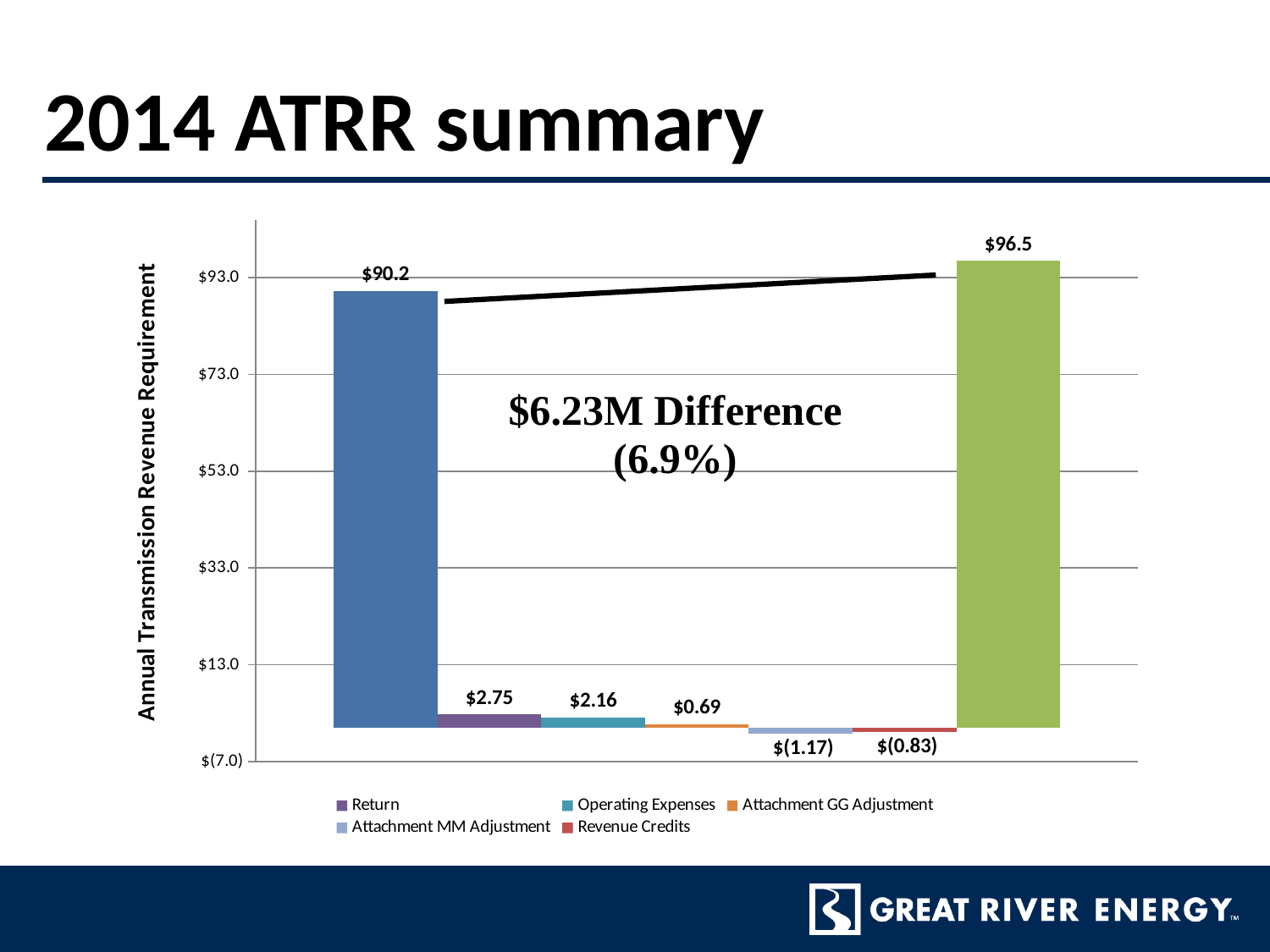
What is the value labelled on the Attachment GG Adjustment bar? $0.69 What value is labelled on the tall blue bar at the left of the chart? $90.2 What is the value labelled on the Attachment MM Adjustment bar? $(1.17) What kind of chart is shown on the slide? bar chart Is the value of the green bar at the right greater or less than $93.0? greater What is the difference between the Return value and the Operating Expenses value? $0.59 What is the value labelled on the Revenue Credits bar? $(0.83) What is the value labelled on the Return bar? $2.75 What is the value labelled on the Operating Expenses bar? $2.16 Which is larger, the Return value or the Operating Expenses value? Return What value is labelled on the tall green bar at the right of the chart? $96.5 How many series does the legend list? 5